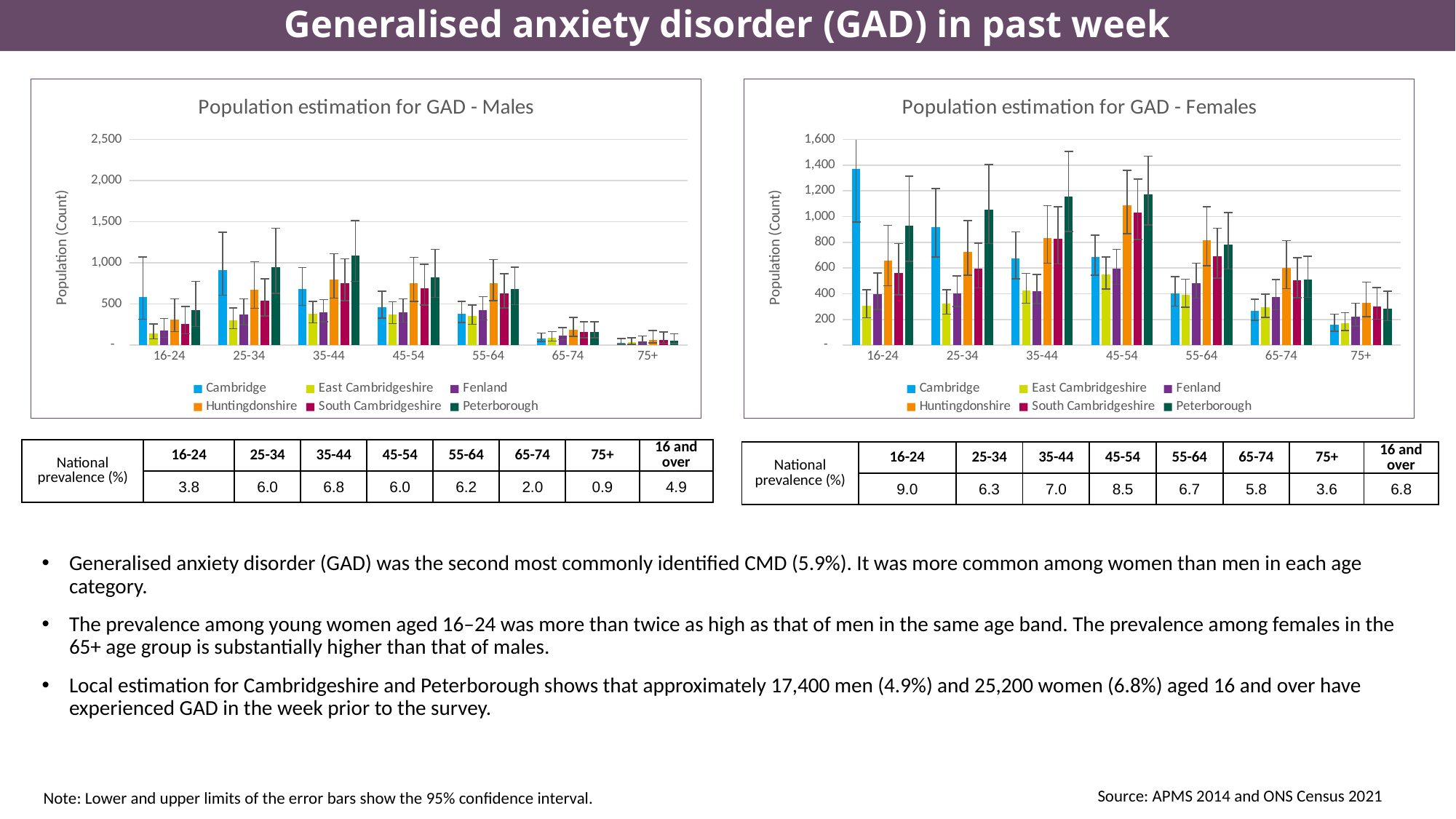
In the 'Population estimation for GAD - Males' chart, which is larger in the 16-24 age group: Cambridge or Peterborough? Cambridge What kind of chart is the 'Population estimation for GAD - Males' chart? Bar chart How many series does the legend of the 'Population estimation for GAD - Females' chart list? 6 In the 'Population estimation for GAD - Females' chart, which area has the highest bar in the 16-24 age group? Cambridge In the 'Population estimation for GAD - Females' chart, is the value for Cambridge in the 16-24 age group greater or less than 1,200? greater What is the y-axis label on the 'Population estimation for GAD - Females' chart? Population (Count) In the 'Population estimation for GAD - Males' chart, is the value for Peterborough in the 35-44 age group greater or less than 1,000? greater In the 'Population estimation for GAD - Males' chart, is the value for Cambridge in the 25-34 age group greater or less than 1,000? less How many age-group categories are shown on the x axis of the 'Population estimation for GAD - Males' chart? 7 In the 'Population estimation for GAD - Males' chart, which age group has the lowest values across all areas? 75+ In the 'Population estimation for GAD - Males' chart, do the values for Cambridge rise or fall from the 55-64 age group to the 75+ age group? fall